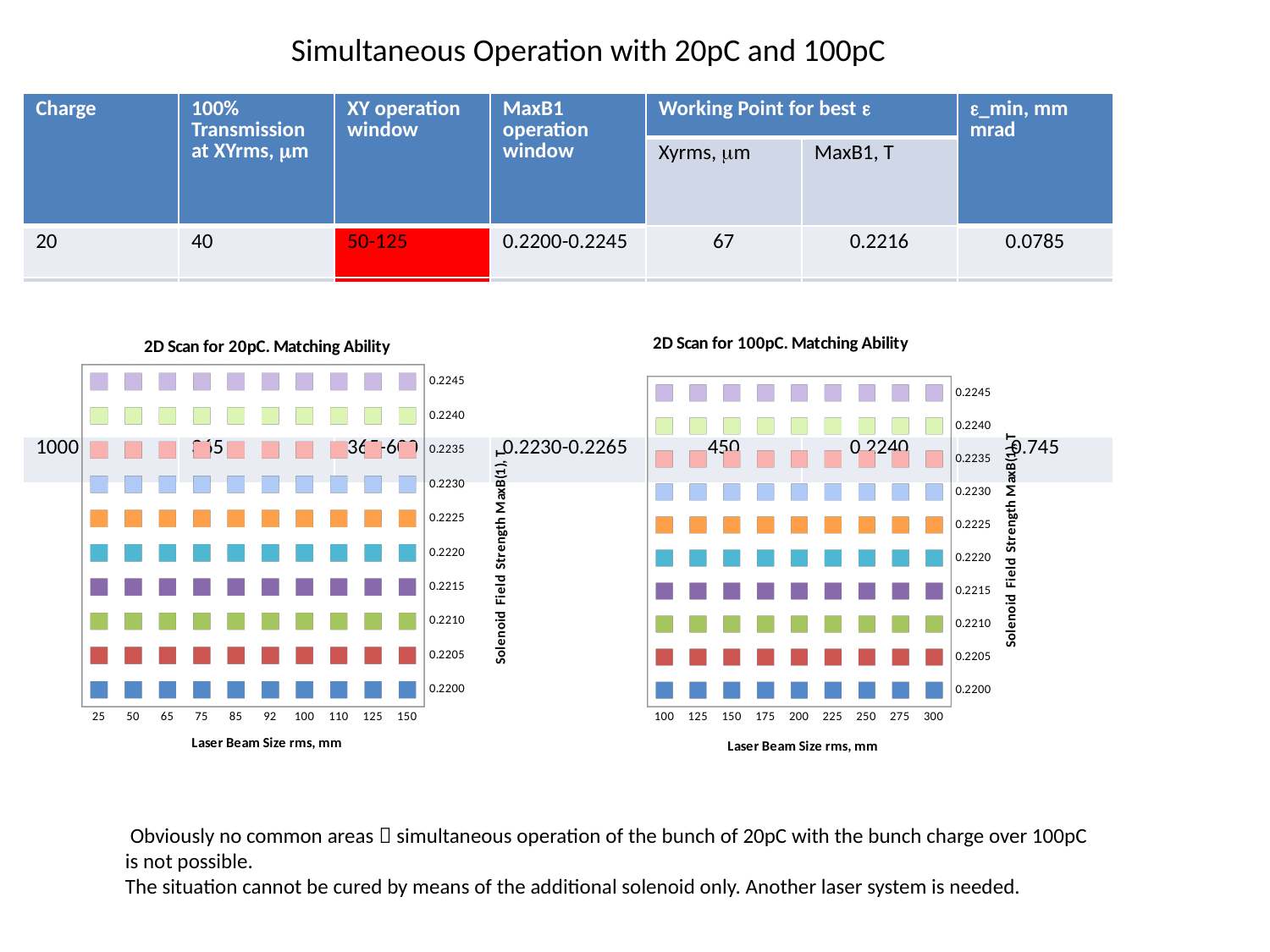
In the chart titled '2D Scan for 100pC. Matching Ability', what is the smallest laser beam size value on the x axis? 100 In the chart titled '2D Scan for 20pC. Matching Ability', what is the smallest laser beam size value on the x axis? 25 In the chart titled '2D Scan for 100pC. Matching Ability', what is the lowest solenoid field strength value shown on the y axis? 0.2200 In the chart titled '2D Scan for 20pC. Matching Ability', what is the highest solenoid field strength value shown on the y axis? 0.2245 In the chart titled '2D Scan for 100pC. Matching Ability', what is the largest laser beam size value on the x axis? 300 What is the title of the chart on the right side of the slide? 2D Scan for 100pC. Matching Ability What kind of chart is '2D Scan for 100pC. Matching Ability'? scatter chart What is the title of the chart on the left side of the slide? 2D Scan for 20pC. Matching Ability In the chart titled '2D Scan for 20pC. Matching Ability', what is the largest laser beam size value on the x axis? 150 In the chart titled '2D Scan for 20pC. Matching Ability', how many laser beam size values are listed along the x axis? 10 In the chart titled '2D Scan for 20pC. Matching Ability', how many distinct solenoid field strength levels are plotted? 10 In the chart titled '2D Scan for 100pC. Matching Ability', how many laser beam size values are listed along the x axis? 9